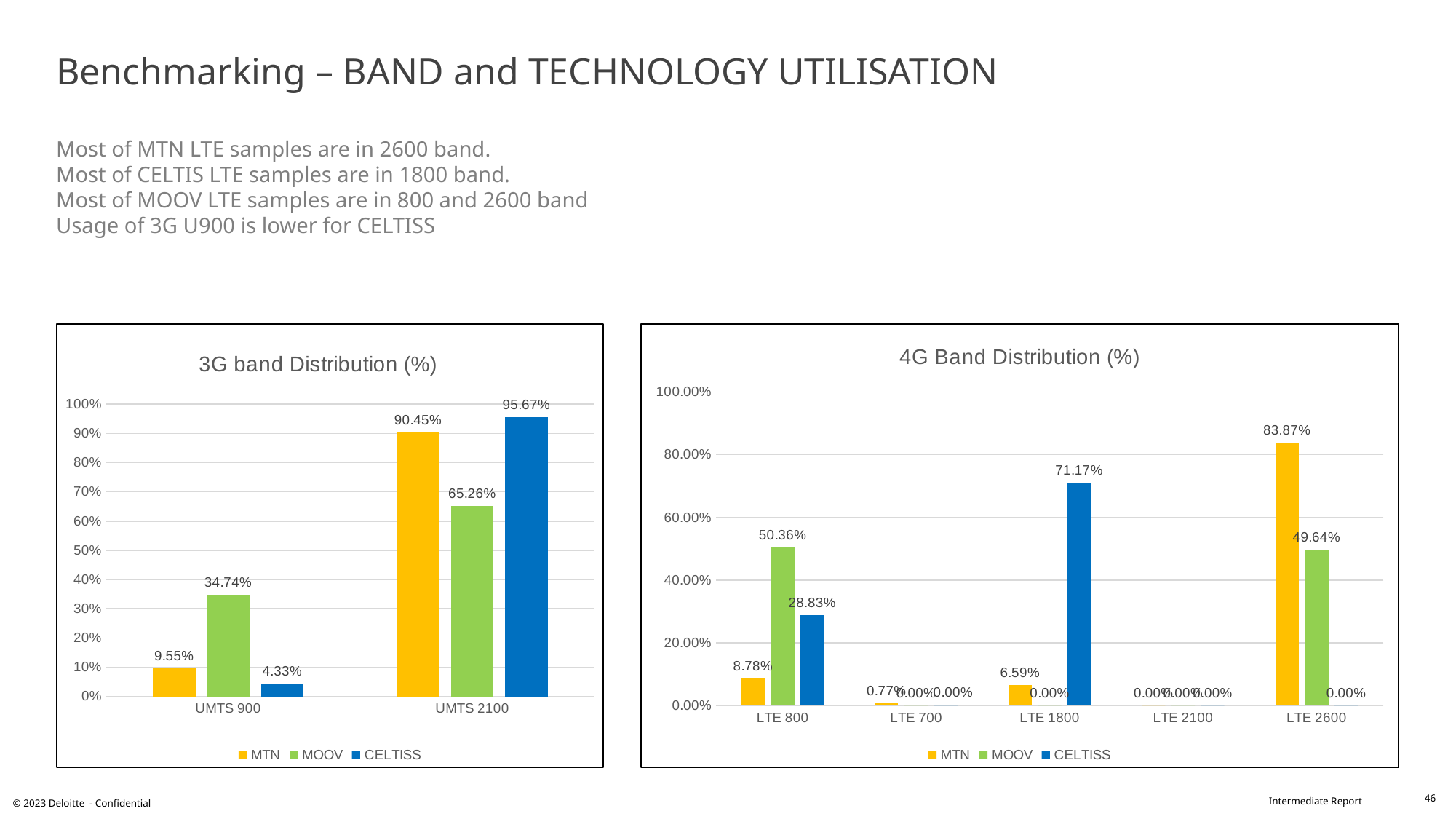
In the 4G Band Distribution (%) chart, what is the difference between the MOOV and CELTISS values at LTE 800? 21.53% In the 4G Band Distribution (%) chart, which series has the highest value at LTE 800? MOOV In the 3G band Distribution (%) chart, which series has the lowest value at UMTS 900? CELTISS In the 3G band Distribution (%) chart, how many categories are shown on the x axis? 2 In the 3G band Distribution (%) chart, what is the difference between the CELTISS and MTN values at UMTS 2100? 5.22% In the 4G Band Distribution (%) chart, what is the value for MTN at LTE 2600? 83.87% What type of chart is the 4G Band Distribution (%) chart? Bar chart In the 3G band Distribution (%) chart, what is the value for MOOV at UMTS 900? 34.74% In the 4G Band Distribution (%) chart, how many series does the legend list? 3 In the 4G Band Distribution (%) chart, is the MTN value at LTE 2600 larger or the MOOV value at LTE 2600? MTN In the 3G band Distribution (%) chart, what is the value for CELTISS at UMTS 2100? 95.67% In the 4G Band Distribution (%) chart, what is the value for CELTISS at LTE 1800? 71.17%